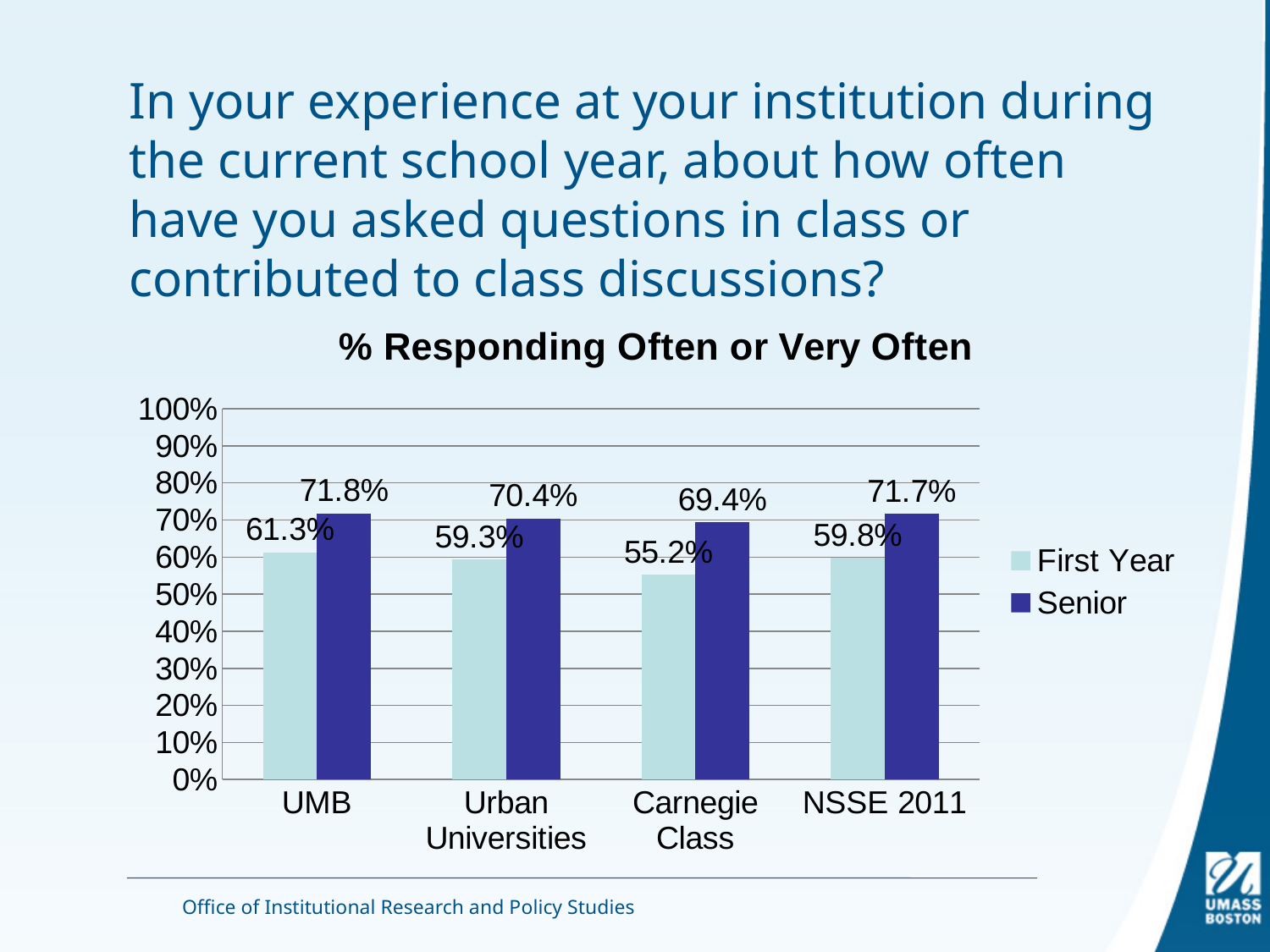
How many categories are shown on the x axis? 4 Which category has the highest First Year value? UMB What is the First Year value for UMB? 61.3% What kind of chart is shown on the slide? Bar chart Which is larger, the Senior value for Urban Universities or the Senior value for Carnegie Class? Urban Universities What is the difference between the Senior and First Year values for UMB? 10.5% What is the difference between the Senior and First Year values for Carnegie Class? 14.2% What is the title of the chart? % Responding Often or Very Often How many series does the legend list? 2 Which category has the lowest First Year value? Carnegie Class What is the Senior value for Carnegie Class? 69.4% What is the First Year value for NSSE 2011? 59.8%